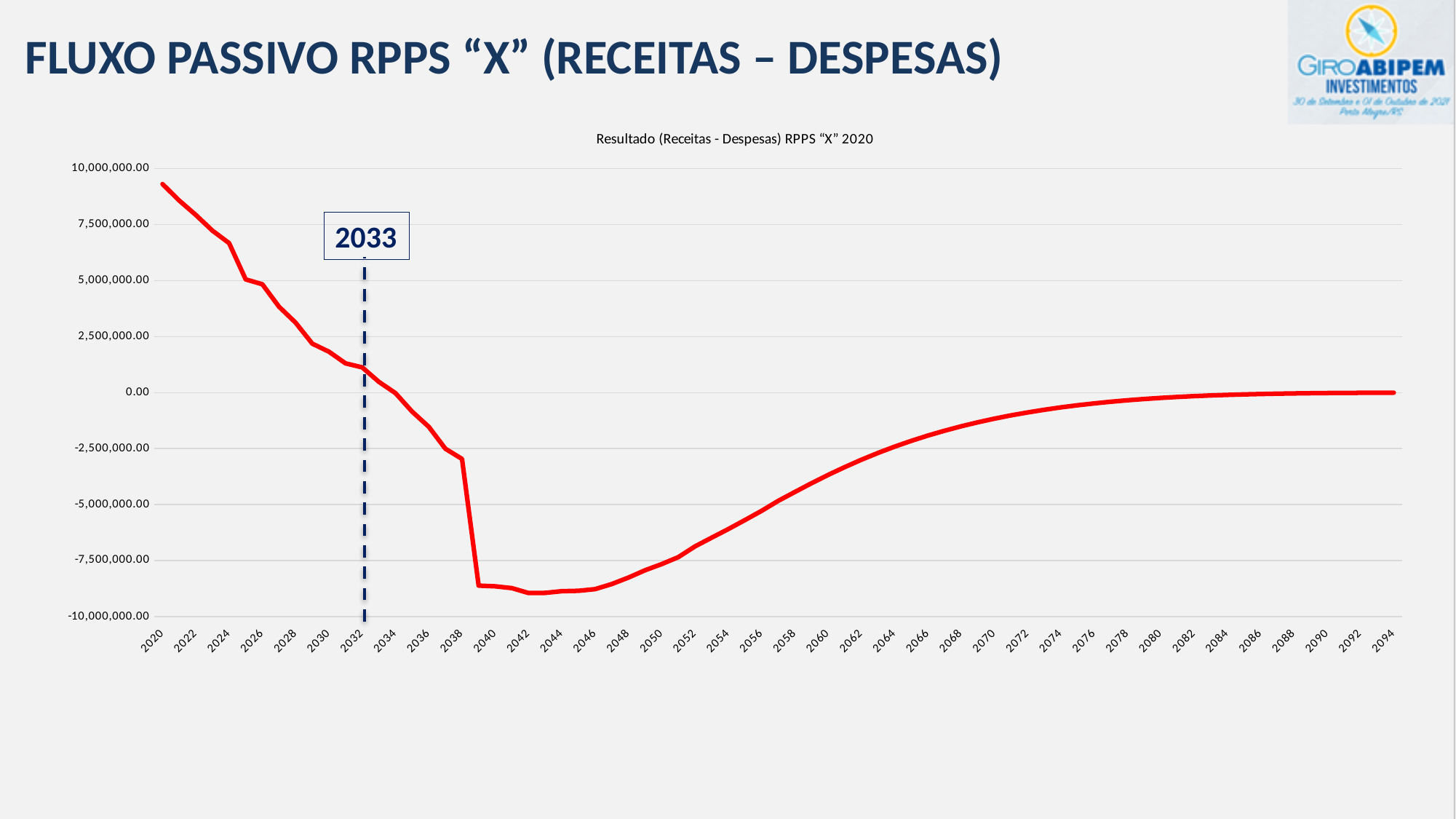
Is the value for 2040 greater or less than -7,500,000.00? less Is the value for 2060 greater or less than -2,500,000.00? less Which year has the highest value on the chart? 2020 What year is marked by the dashed vertical line and the boxed label on the chart? 2033 Do the values rise or fall between 2020 and 2040? Fall Is the value for 2024 greater or less than 5,000,000.00? greater Which is larger, the value for 2040 or the value for 2060? 2060 What is the title of the chart? Resultado (Receitas - Despesas) RPPS "X" 2020 What kind of chart is shown on the slide? Line chart